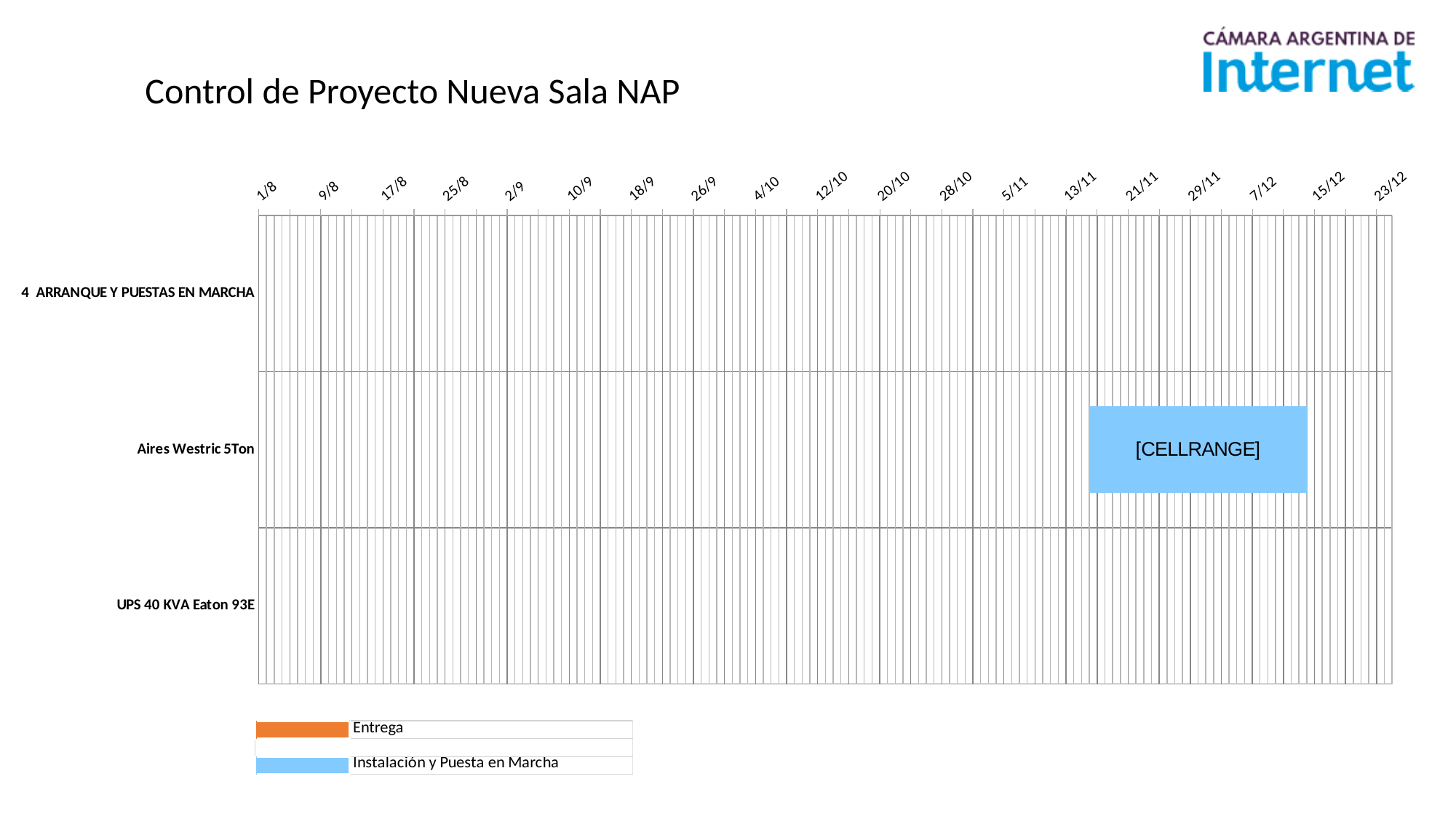
How many series does the chart legend list? 2 What kind of chart is shown on the slide? Bar chart (Gantt chart) What is the first date shown on the horizontal axis? 1/8 Does the bar for Aires Westric 5Ton start before or after 5/11 on the date axis? after What is the title of the slide containing the chart? Control de Proyecto Nueva Sala NAP Does the bar for Aires Westric 5Ton extend past 29/11 on the date axis? yes Which task category has a bar plotted on the chart? Aires Westric 5Ton Which colour represents the 'Entrega' series in the legend? Orange Which legend series does the bar for Aires Westric 5Ton belong to? Instalación y Puesta en Marcha What is the last date shown on the horizontal axis? 23/12 How many task categories are listed on the vertical axis of the chart? 3 Does the bar for Aires Westric 5Ton end before or after 15/12 on the date axis? before